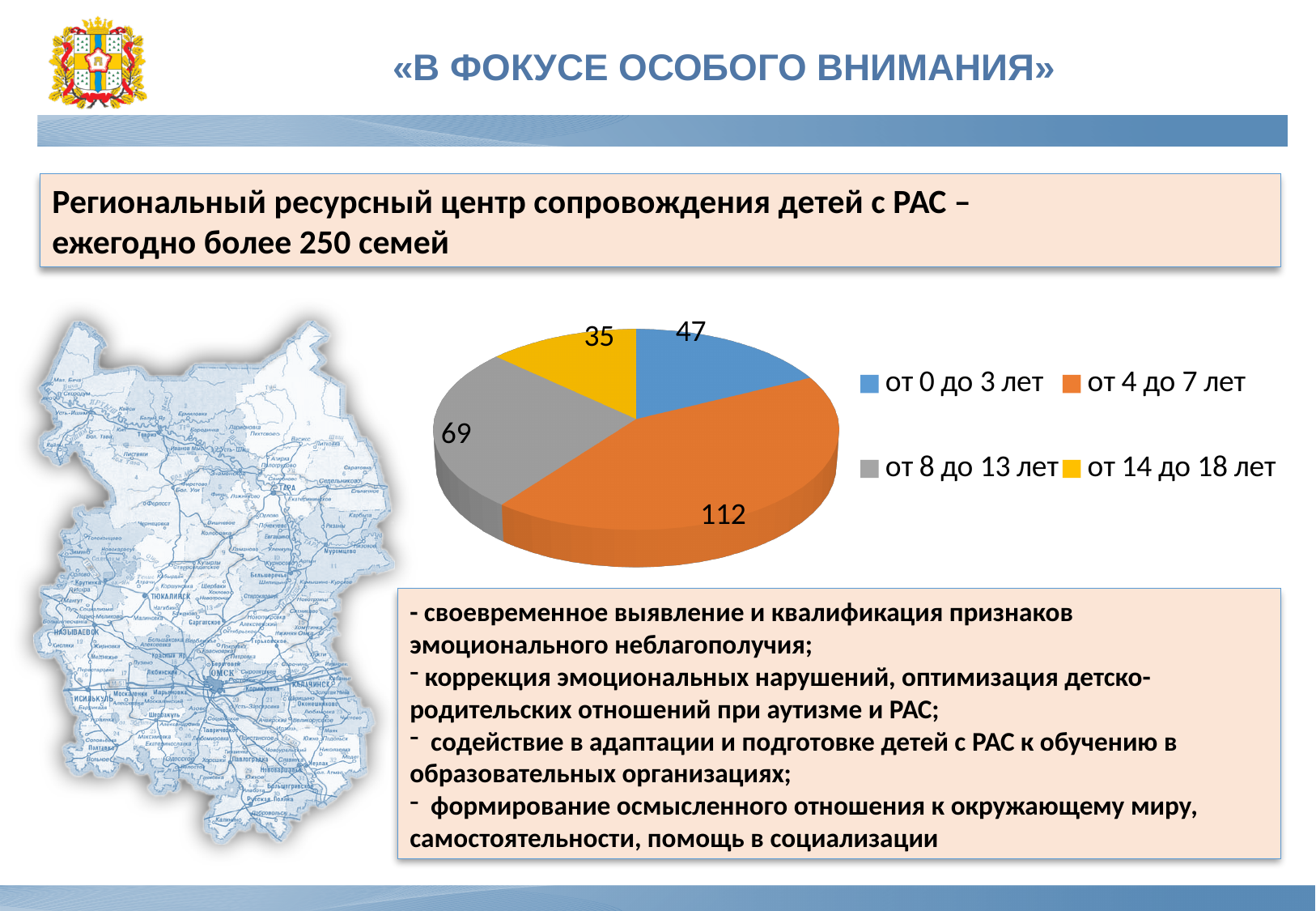
What kind of chart is shown on the slide? pie chart How many entries does the legend of the pie chart list? 4 What is the total of all four slices in the pie chart? 263 Which age group has the smallest slice in the pie chart? от 14 до 18 лет How many slices does the pie chart have? 4 What is the value for the 'от 0 до 3 лет' slice of the pie chart? 47 What is the value for the 'от 14 до 18 лет' slice of the pie chart? 35 What is the value for the 'от 8 до 13 лет' slice of the pie chart? 69 Which is larger: the value for 'от 0 до 3 лет' or the value for 'от 14 до 18 лет'? от 0 до 3 лет Which age group has the largest slice in the pie chart? от 4 до 7 лет What is the difference between the values for 'от 4 до 7 лет' and 'от 8 до 13 лет'? 43 What is the value for the 'от 4 до 7 лет' slice of the pie chart? 112